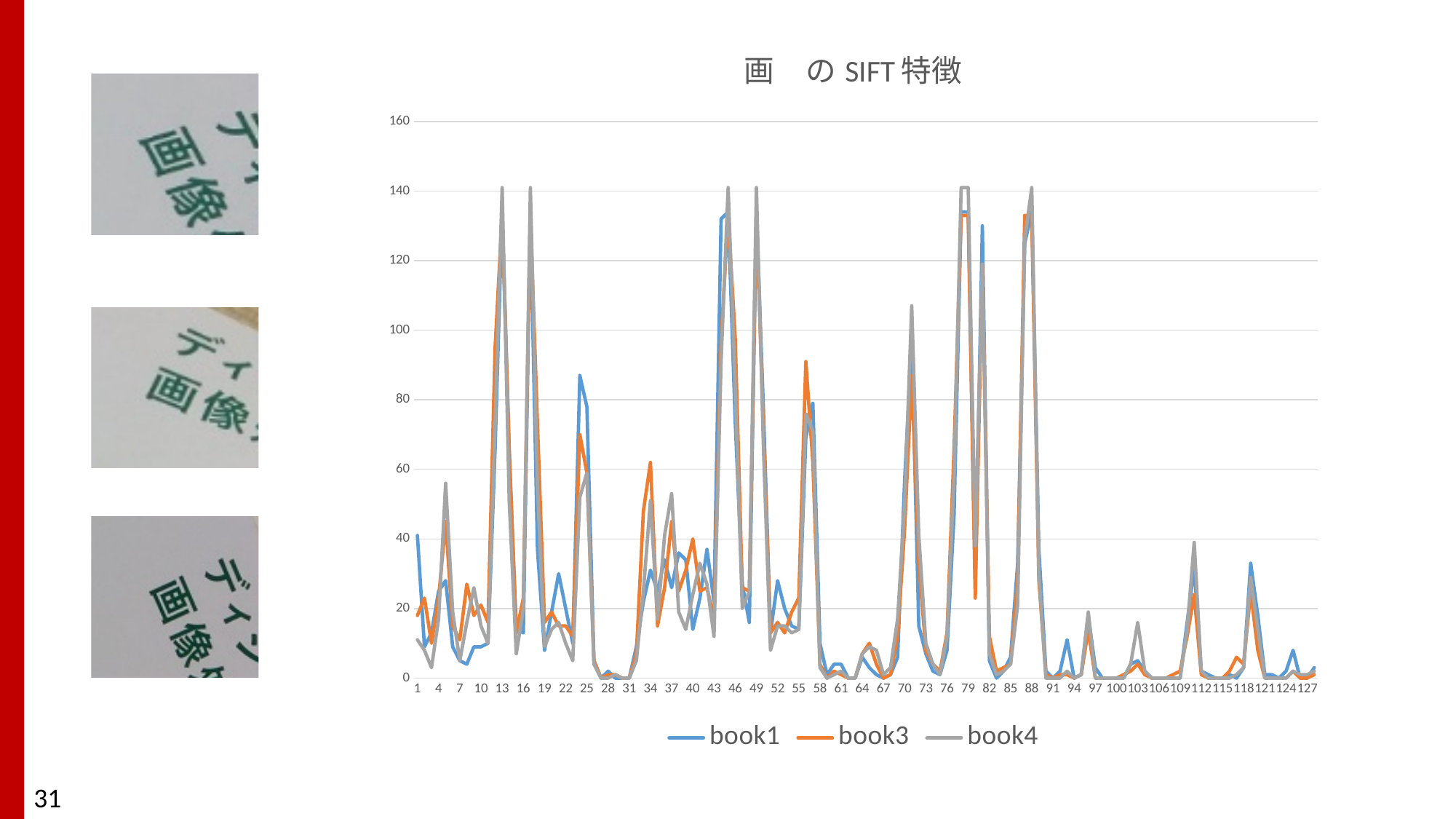
What is the last tick label shown on the horizontal axis? 127 Is the value for book1 at x = 81 greater or less than 120? greater Is the value for book4 at x = 13 greater or less than 120? greater Is the value for book4 at x = 100 greater or less than 20? less Which colour is used for the book3 series? orange What are the series names listed in the legend? book1, book3, book4 How many series does the legend list? 3 What kind of chart is shown on the slide? line chart What is the highest value shown on the vertical axis? 160